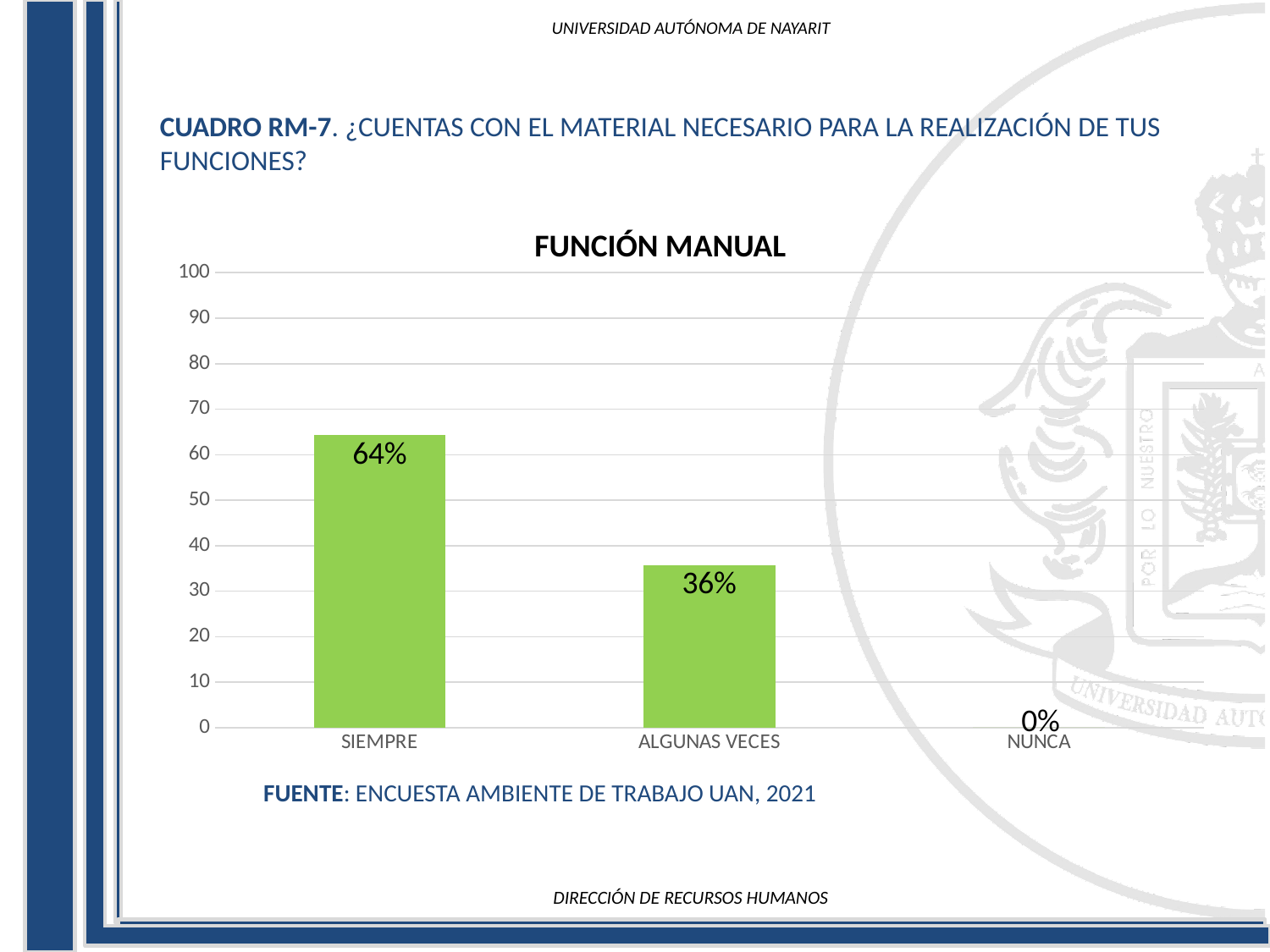
What is the value for ALGUNAS VECES? 36% Do the values rise or fall from left to right along the x axis? fall Which category has the lowest value? NUNCA What is the value for SIEMPRE? 64% Which is larger, the value for SIEMPRE or the value for ALGUNAS VECES? SIEMPRE What is the difference between the values for SIEMPRE and ALGUNAS VECES? 28% What is the title of the chart? FUNCIÓN MANUAL What is the value for NUNCA? 0% How many categories are shown on the x axis? 3 Which category has the highest value? SIEMPRE What kind of chart is shown? bar chart Is the value for ALGUNAS VECES greater or less than 40? less